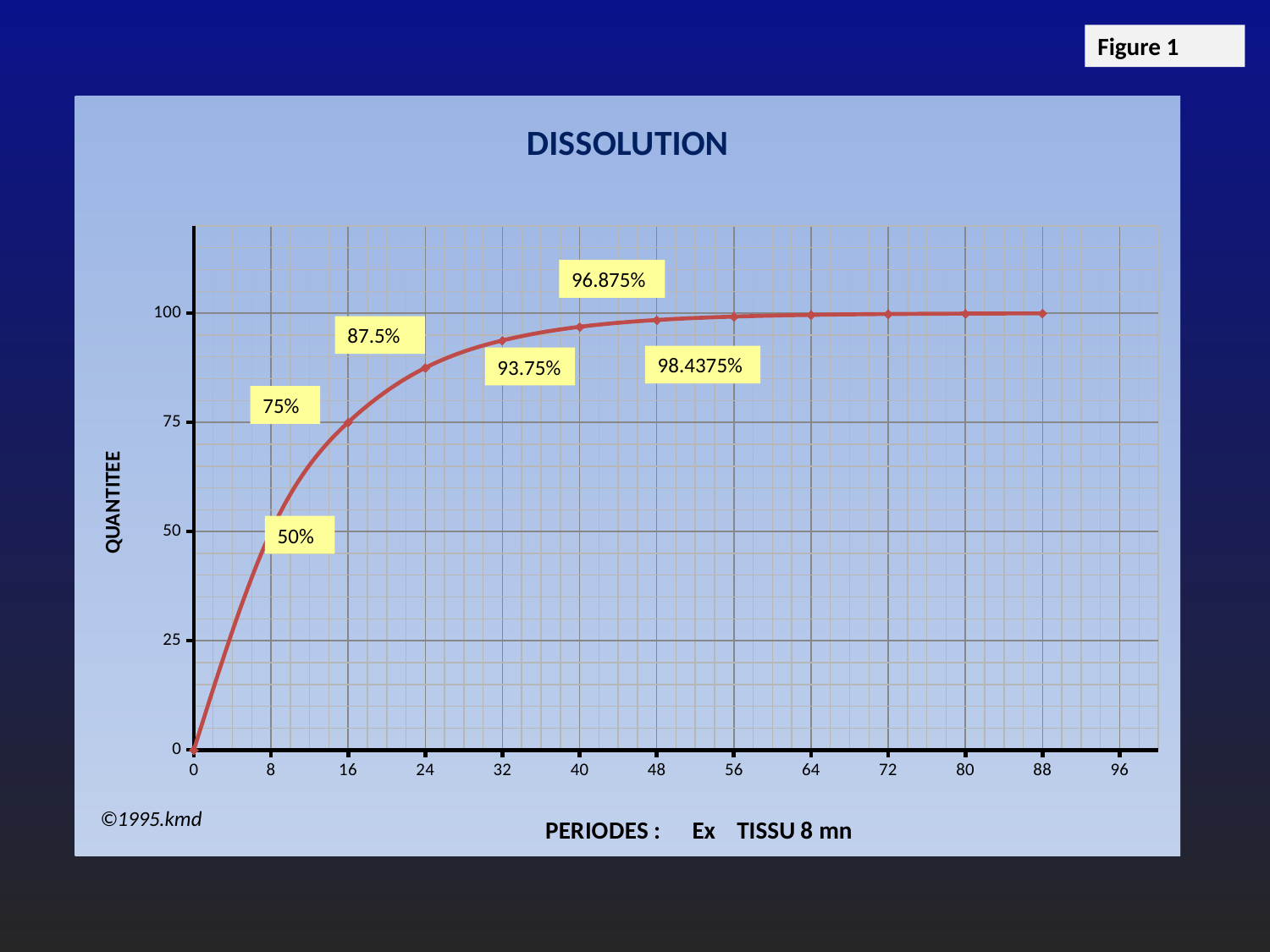
What is the labelled value of the curve at period 48? 98.4375% What is the labelled value of the curve at period 24? 87.5% Do the values rise or fall as the periods increase along the x axis? rise What is the title of the chart? DISSOLUTION What kind of chart is shown on the slide? line chart What is the labelled value of the curve at period 16? 75% What is the difference between the labelled values at period 16 and period 8? 25% What is the labelled value of the curve at period 32? 93.75% Is the value of the curve at period 56 greater or less than 75? greater What is the labelled value of the curve at period 40? 96.875% What is the labelled value of the curve at period 8? 50% Which period has the larger value, 24 or 8? 24